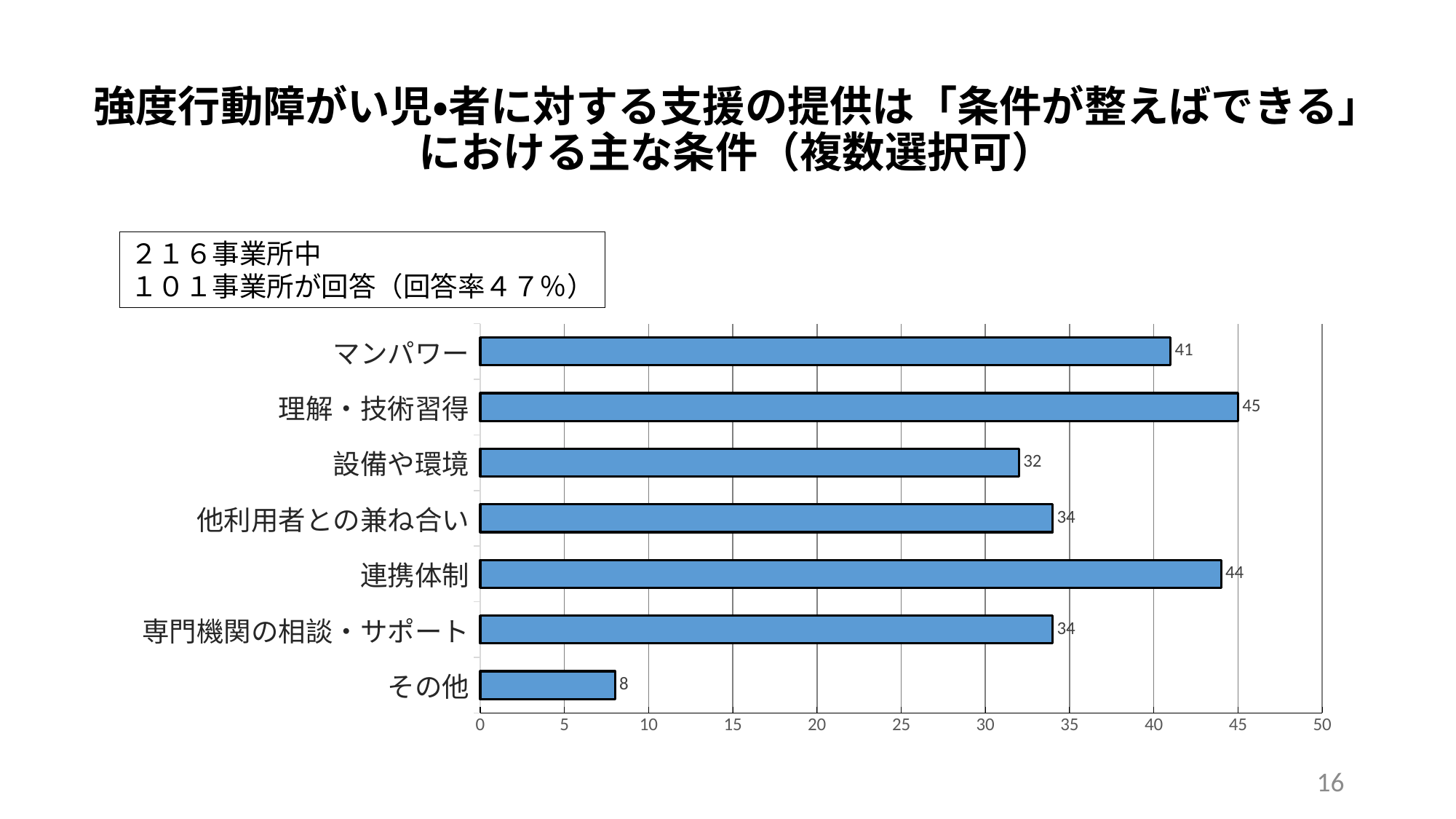
What is the maximum value shown on the horizontal axis? 50 What is the difference between the values for 理解・技術習得 and 連携体制? 1 Which category has the highest value? 理解・技術習得 What is the value for マンパワー? 41 How many categories are shown in the chart? 7 What kind of chart is shown on the slide? bar chart What is the value for 設備や環境? 32 Is the value for 専門機関の相談・サポート greater or less than 30? greater Which category has the lowest value? その他 What is the value for その他? 8 Which is larger, the value for 連携体制 or the value for 他利用者との兼ね合い? 連携体制 What is the difference between the values for マンパワー and 設備や環境? 9